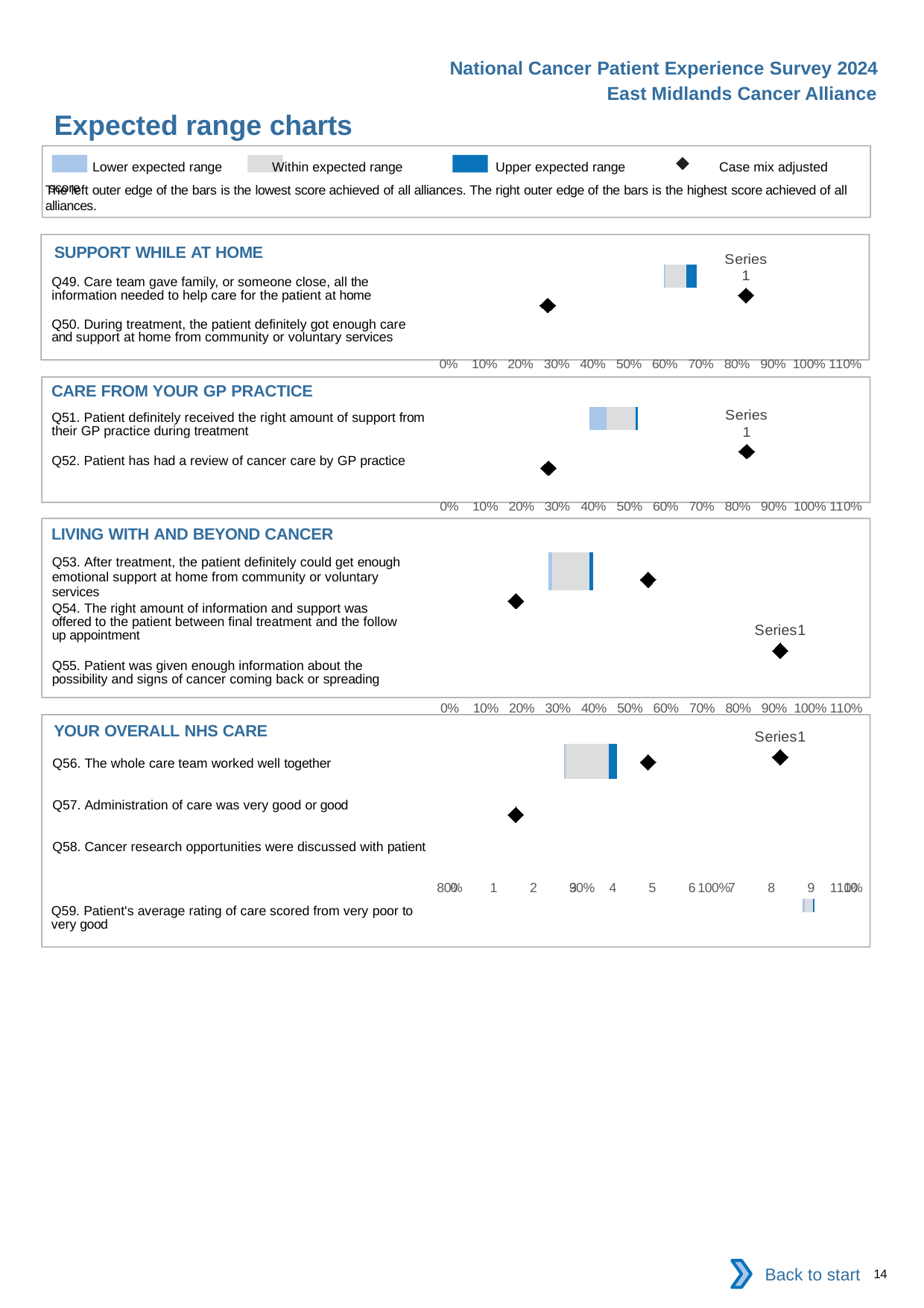
How many questions are listed in the SUPPORT WHILE AT HOME chart? 2 In the CARE FROM YOUR GP PRACTICE chart, is the lowest diamond marker greater or less than 50%? less How many entries does the legend at the top of the slide list? 4 What kind of chart is used in the SUPPORT WHILE AT HOME section? bar chart How many questions are listed in the YOUR OVERALL NHS CARE chart? 4 In the LIVING WITH AND BEYOND CANCER chart, is the lowest diamond marker greater or less than 30%? less How many section charts are shown on the slide? 4 In the SUPPORT WHILE AT HOME chart, is the lowest diamond marker greater or less than 40%? less According to the legend, what does the diamond marker represent? Case mix adjusted score What is the highest percentage shown on the x axis of the CARE FROM YOUR GP PRACTICE chart? 110%